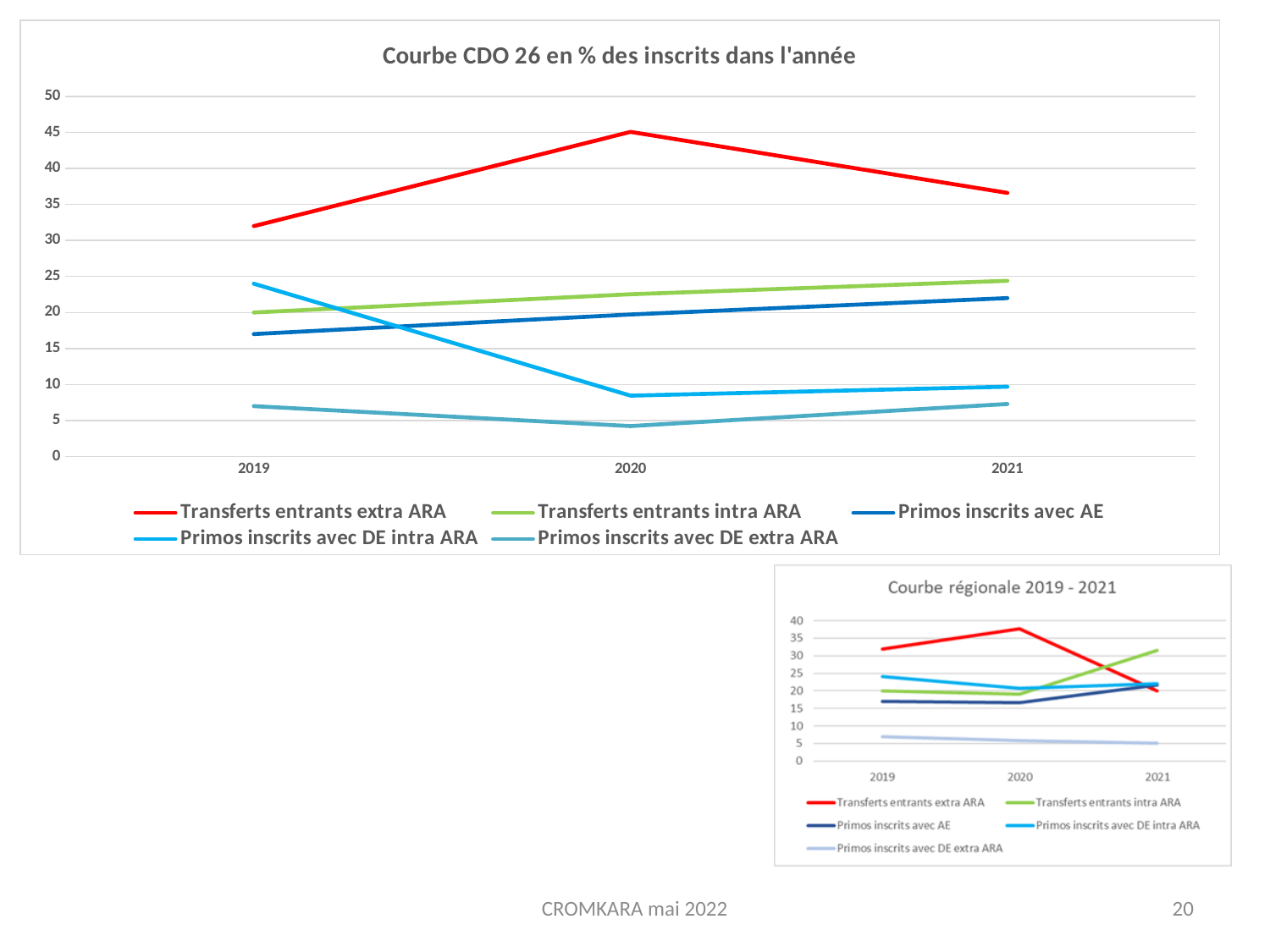
In the chart titled "Courbe CDO 26 en % des inscrits dans l'année", what kind of chart is shown? Line chart In the chart titled "Courbe CDO 26 en % des inscrits dans l'année", how many years are shown on the x axis? 3 In the chart titled "Courbe CDO 26 en % des inscrits dans l'année", which is larger in 2019: Primos inscrits avec DE intra ARA or Transferts entrants intra ARA? Primos inscrits avec DE intra ARA In the chart titled "Courbe régionale 2019 - 2021", does the Transferts entrants extra ARA line rise or fall from 2020 to 2021? falls In the chart titled "Courbe CDO 26 en % des inscrits dans l'année", how many series does the legend list? 5 In the chart titled "Courbe CDO 26 en % des inscrits dans l'année", does the Transferts entrants intra ARA line rise or fall from 2019 to 2021? rises In the chart titled "Courbe CDO 26 en % des inscrits dans l'année", which series has the highest value in 2020? Transferts entrants extra ARA In the chart titled "Courbe CDO 26 en % des inscrits dans l'année", is the value for Transferts entrants extra ARA in 2020 greater or less than 40? greater In the chart titled "Courbe régionale 2019 - 2021", is the value for Transferts entrants extra ARA in 2020 greater or less than 35? greater In the chart titled "Courbe CDO 26 en % des inscrits dans l'année", is the value for Primos inscrits avec DE intra ARA in 2020 greater or less than 10? less In the chart titled "Courbe régionale 2019 - 2021", which series has the highest value in 2021? Transferts entrants intra ARA In the chart titled "Courbe CDO 26 en % des inscrits dans l'année", which series has the lowest value in 2020? Primos inscrits avec DE extra ARA